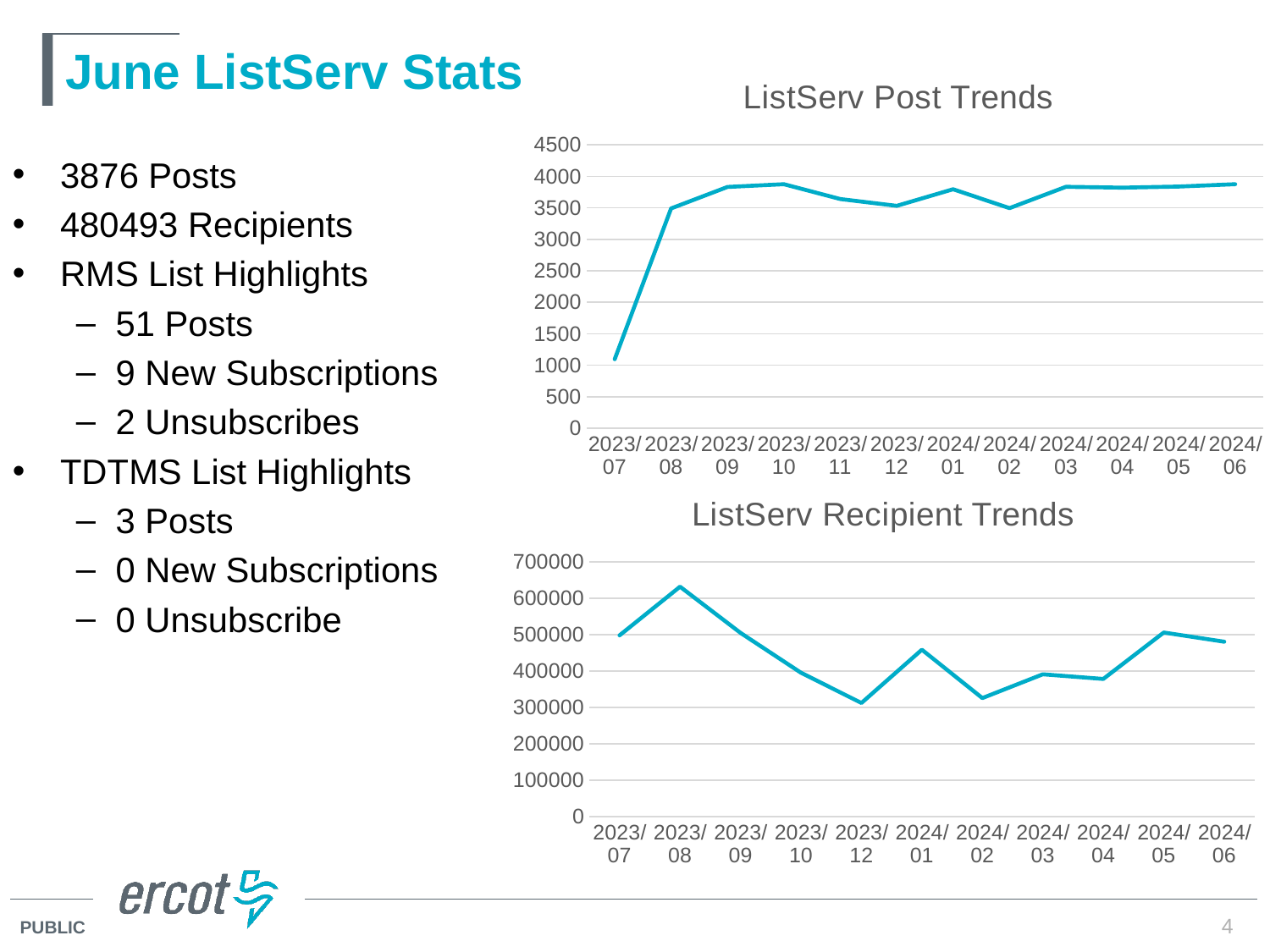
In the ListServ Recipient Trends chart, which month has the highest value? 2023/08 In the ListServ Recipient Trends chart, which is larger, the value for 2023/08 or the value for 2024/05? 2023/08 In the ListServ Recipient Trends chart, is the value for 2023/08 greater or less than 600000? greater In the ListServ Post Trends chart, is the value for 2023/07 greater or less than 1500? less In the ListServ Recipient Trends chart, how many months are plotted along the x axis? 11 What kind of chart is the ListServ Recipient Trends chart? line chart In the ListServ Post Trends chart, how many months are plotted along the x axis? 12 In the ListServ Post Trends chart, is the value for 2024/06 greater or less than 3500? greater In the ListServ Post Trends chart, which month has the lowest value? 2023/07 In the ListServ Recipient Trends chart, do the values rise or fall from 2023/08 to 2023/12? fall What kind of chart is the ListServ Post Trends chart? line chart